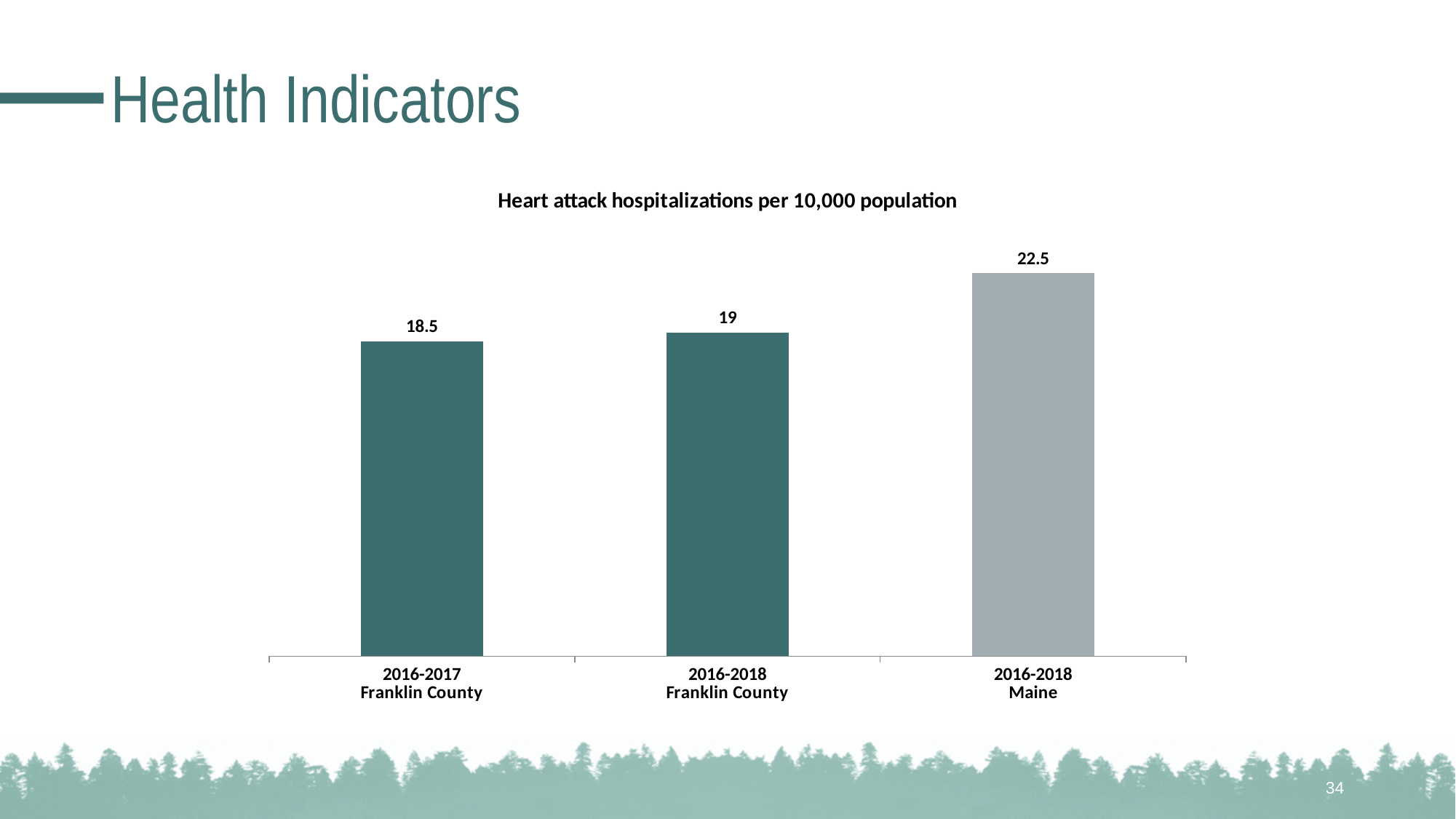
What is the title of the chart? Heart attack hospitalizations per 10,000 population What is the value for 2016-2018 Maine? 22.5 What is the value for 2016-2018 Franklin County? 19 What is the value for 2016-2017 Franklin County? 18.5 Which category has the lowest value? 2016-2017 Franklin County Do the values rise or fall from left to right across the categories? Rise What is the difference between the value for 2016-2018 Franklin County and the value for 2016-2017 Franklin County? 0.5 What kind of chart is shown on the slide? Bar chart Which category has the highest value? 2016-2018 Maine How many bars are shown in the chart? 3 Which is larger, the value for 2016-2018 Maine or the value for 2016-2017 Franklin County? 2016-2018 Maine What is the difference between the value for 2016-2018 Maine and the value for 2016-2018 Franklin County? 3.5